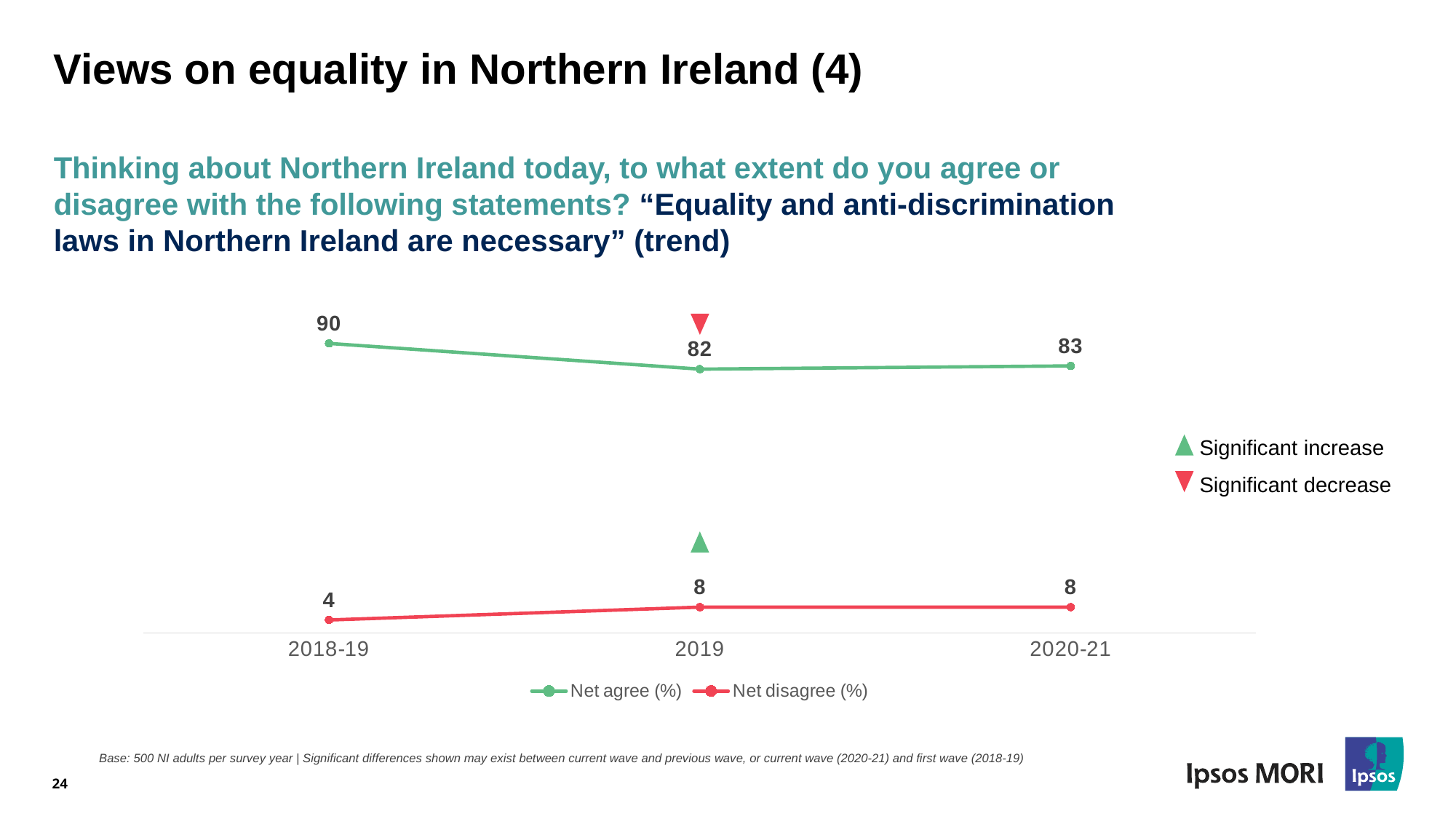
How many time points are shown on the x axis? 3 How many series does the legend list? 2 What is the difference between Net agree (%) and Net disagree (%) in 2020-21? 75 In which year is Net disagree (%) lowest? 2018-19 In which year is Net agree (%) lowest? 2019 Does Net disagree (%) rise or fall from 2018-19 to 2019? Rise Which is larger: Net agree (%) in 2018-19 or Net agree (%) in 2020-21? 2018-19 What is the Net agree (%) value for 2020-21? 83 What is the difference between Net agree (%) in 2018-19 and 2019? 8 What kind of chart is shown on the slide? Line chart What is the Net agree (%) value for 2018-19? 90 What is the Net disagree (%) value for 2019? 8